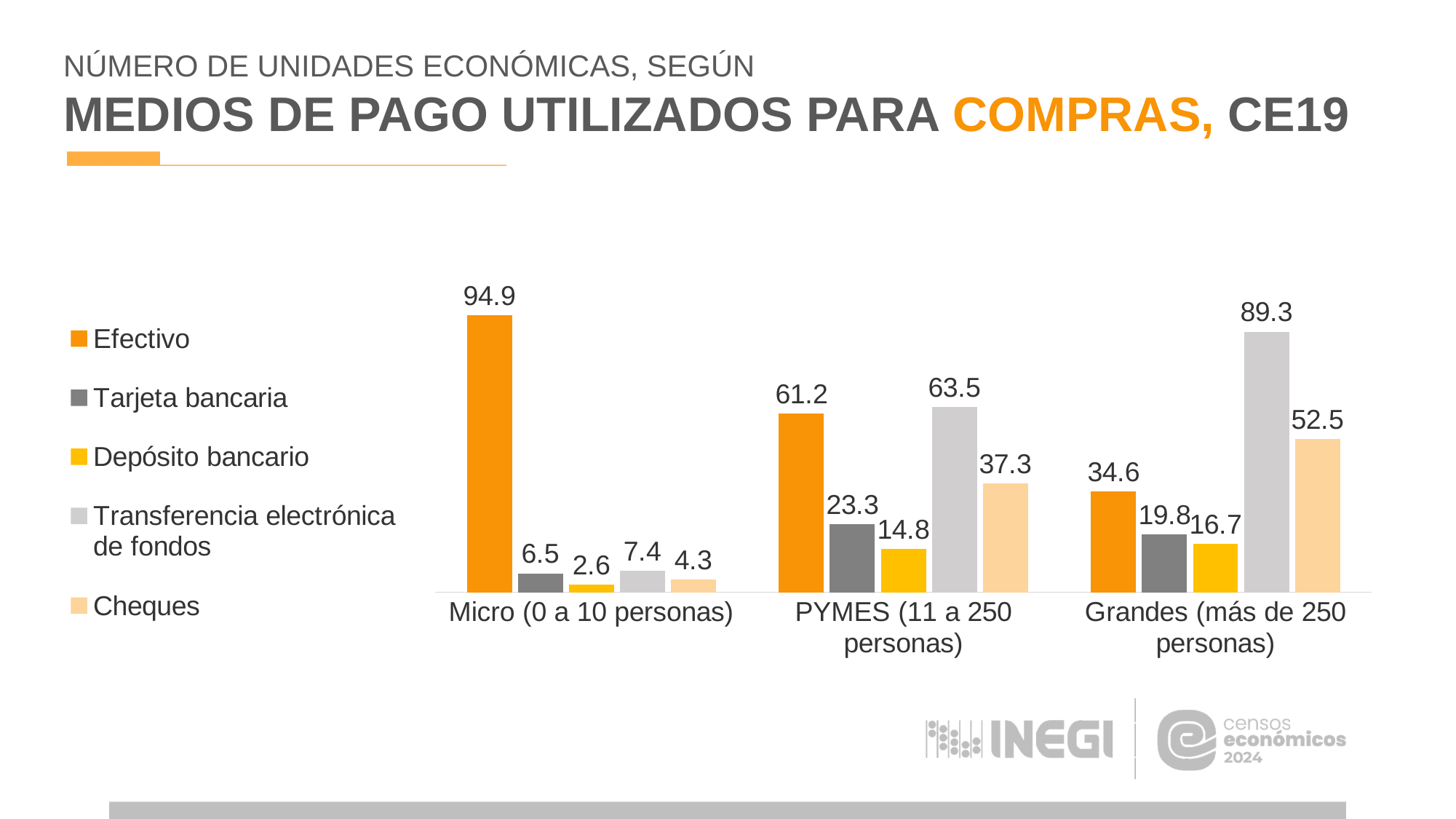
How many categories are shown on the x axis? 3 What is the value for Depósito bancario in the Micro (0 a 10 personas) category? 2.6 What is the difference between Efectivo and Tarjeta bancaria in the PYMES (11 a 250 personas) category? 37.9 How many series does the legend list? 5 Which payment method has the lowest value in the Grandes (más de 250 personas) category? Depósito bancario Does the value for Efectivo rise or fall from Micro to Grandes? Fall What is the value for Efectivo in the Micro (0 a 10 personas) category? 94.9 What is the value for Transferencia electrónica de fondos in the Grandes (más de 250 personas) category? 89.3 Which payment method has the highest value in the PYMES (11 a 250 personas) category? Transferencia electrónica de fondos Which is larger: Cheques for Grandes (más de 250 personas) or Cheques for PYMES (11 a 250 personas)? Cheques for Grandes (más de 250 personas) What kind of chart is shown on the slide? Bar chart What is the value for Cheques in the PYMES (11 a 250 personas) category? 37.3